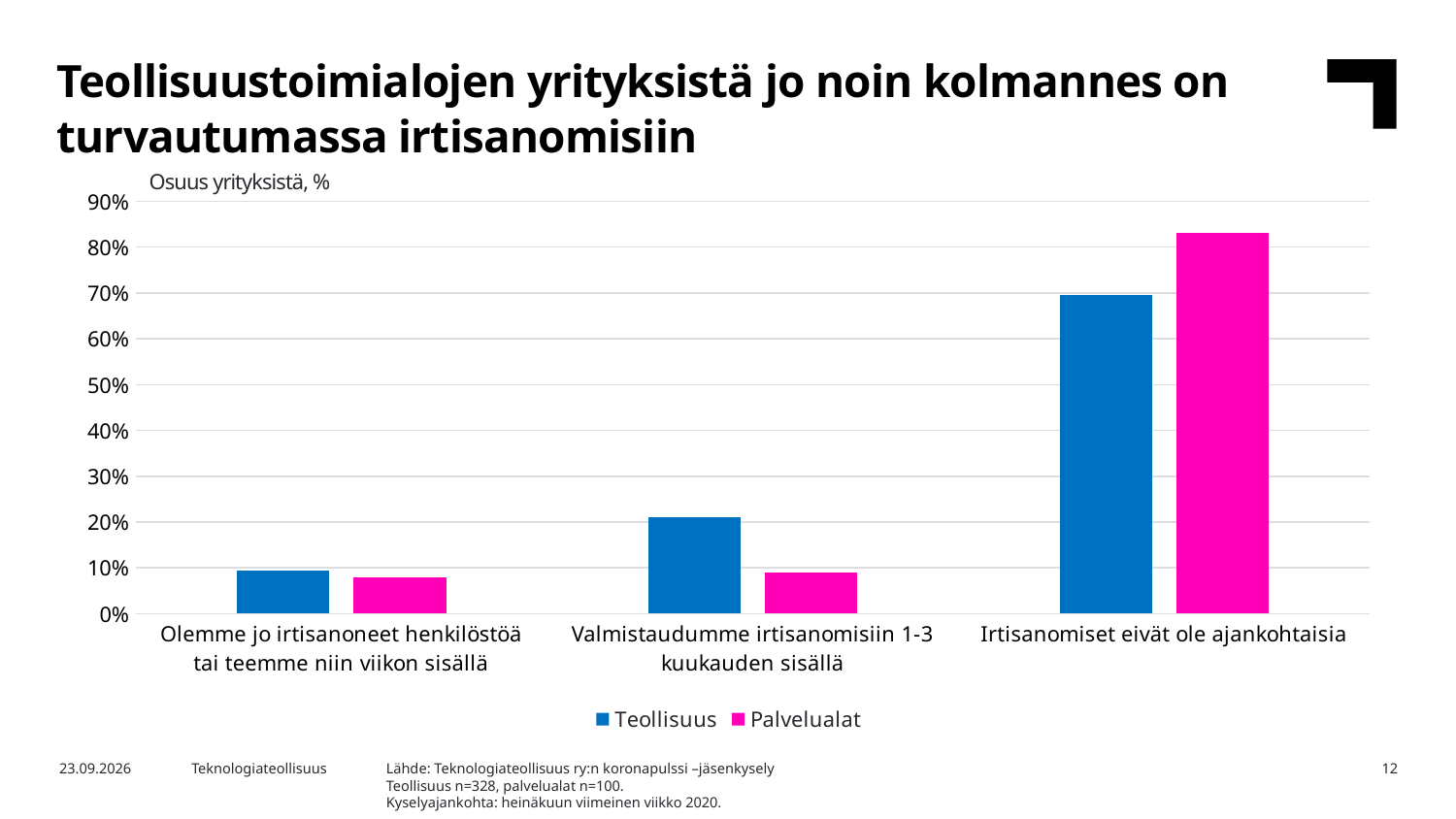
What kind of chart is shown on the slide? bar chart Is the Teollisuus value for 'Irtisanomiset eivät ole ajankohtaisia' greater or less than 60%? greater Is the Palvelualat value for 'Irtisanomiset eivät ole ajankohtaisia' greater or less than 70%? greater How many series does the legend list? 2 Which category has the lowest value for Teollisuus? Olemme jo irtisanoneet henkilöstöä tai teemme niin viikon sisällä Is the Teollisuus value for 'Valmistaudumme irtisanomisiin 1-3 kuukauden sisällä' greater or less than 30%? less For 'Valmistaudumme irtisanomisiin 1-3 kuukauden sisällä', which series has the larger value, Teollisuus or Palvelualat? Teollisuus How many categories are shown on the x axis? 3 For 'Irtisanomiset eivät ole ajankohtaisia', which series has the larger value, Teollisuus or Palvelualat? Palvelualat Which category has the highest value for Palvelualat? Irtisanomiset eivät ole ajankohtaisia Which category has the highest value for Teollisuus? Irtisanomiset eivät ole ajankohtaisia